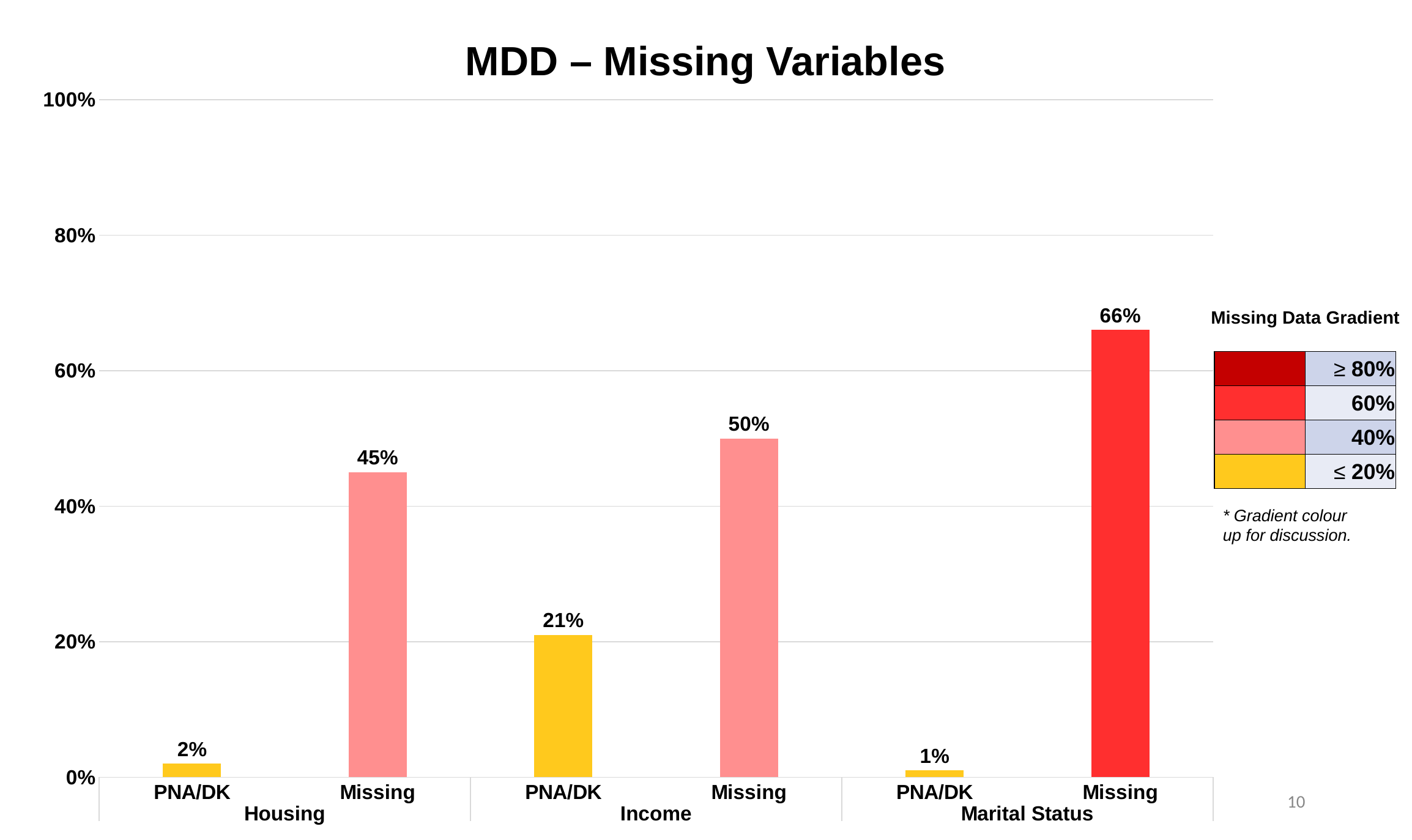
How many bars are plotted in the chart? 6 Which bar has the lowest value? PNA/DK under Marital Status What is the value for PNA/DK under Marital Status? 1% Is the value for Missing under Marital Status greater or less than 60%? greater What is the value for Missing under Marital Status? 66% What is the difference between Missing under Income and Missing under Housing? 5% Which bar has the highest value? Missing under Marital Status Which is larger: PNA/DK under Income or PNA/DK under Housing? PNA/DK under Income What is the value for PNA/DK under Income? 21% What is the title of the chart? MDD – Missing Variables What is the value for Missing under Housing? 45% What kind of chart is shown? bar chart